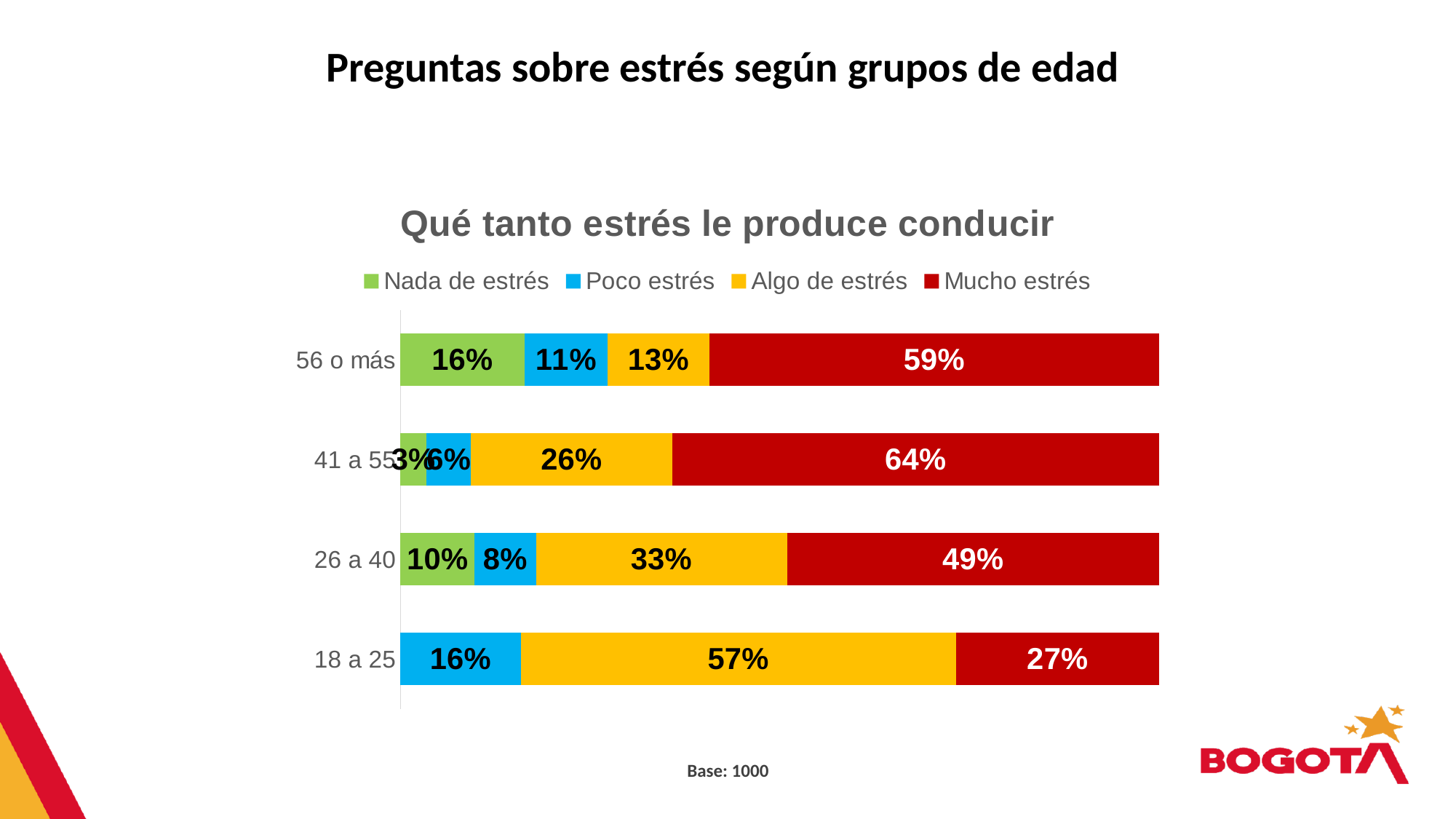
What is the difference between the Mucho estrés values for 41 a 55 and 26 a 40? 15% What kind of chart is shown on the slide? Stacked bar chart What is the title of the chart? Qué tanto estrés le produce conducir What is the Algo de estrés value for the 18 a 25 group? 57% What percentage of the 56 o más group reports Mucho estrés? 59% How many series does the legend list? 4 Which is larger: the Algo de estrés value for 26 a 40 or for 41 a 55? 26 a 40 What is the Poco estrés value for the 26 a 40 group? 8% What is the Nada de estrés value for the 41 a 55 group? 3% Which age group has the lowest Mucho estrés value? 18 a 25 Which age group has the highest Mucho estrés value? 41 a 55 How many age groups are shown in the chart? 4